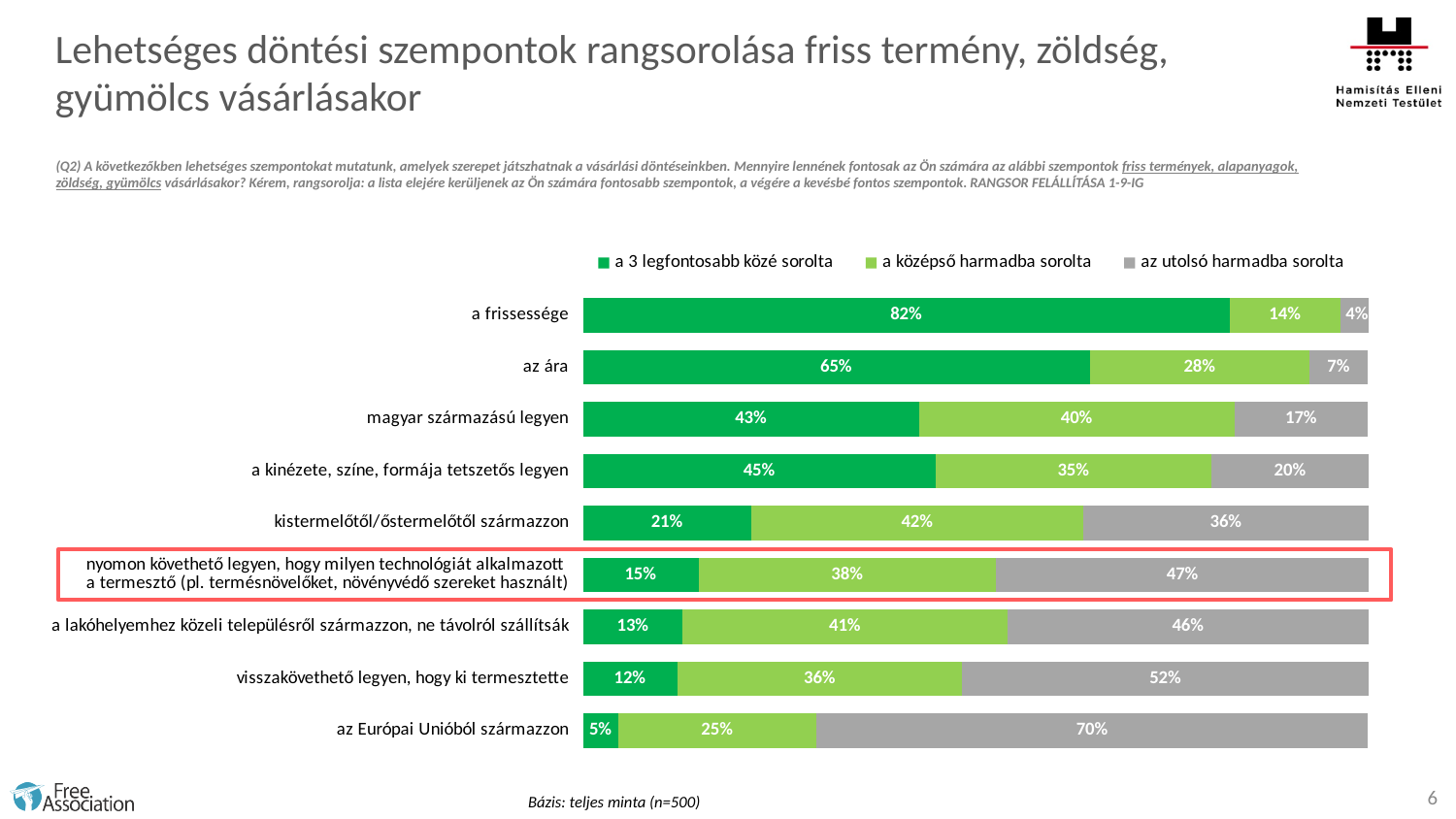
What is the difference between the "a 3 legfontosabb közé sorolta" values for "a frissessége" and "az ára"? 17% What kind of chart is shown on the slide? stacked bar chart What percentage of respondents ranked "a frissessége" among the 3 most important aspects ("a 3 legfontosabb közé sorolta")? 82% What is the value of "a középső harmadba sorolta" for "kistermelőtől/őstermelőtől származzon"? 42% Which has a larger "az utolsó harmadba sorolta" value: "visszakövethető legyen, hogy ki termesztette" or "a lakóhelyemhez közeli településről származzon, ne távolról szállítsák"? visszakövethető legyen, hogy ki termesztette Which category has the highest value for "a 3 legfontosabb közé sorolta"? a frissessége What is the total of the stacked bar for "magyar származású legyen"? 100% What is the value of "az utolsó harmadba sorolta" for "az Európai Unióból származzon"? 70% Which category has the lowest value for "a 3 legfontosabb közé sorolta"? az Európai Unióból származzon How many categories are shown in the chart? 9 How many series does the legend list? 3 Which category is highlighted with a red box on the chart? nyomon követhető legyen, hogy milyen technológiát alkalmazott a termesztő (pl. termésnövelőket, növényvédő szereket használt)